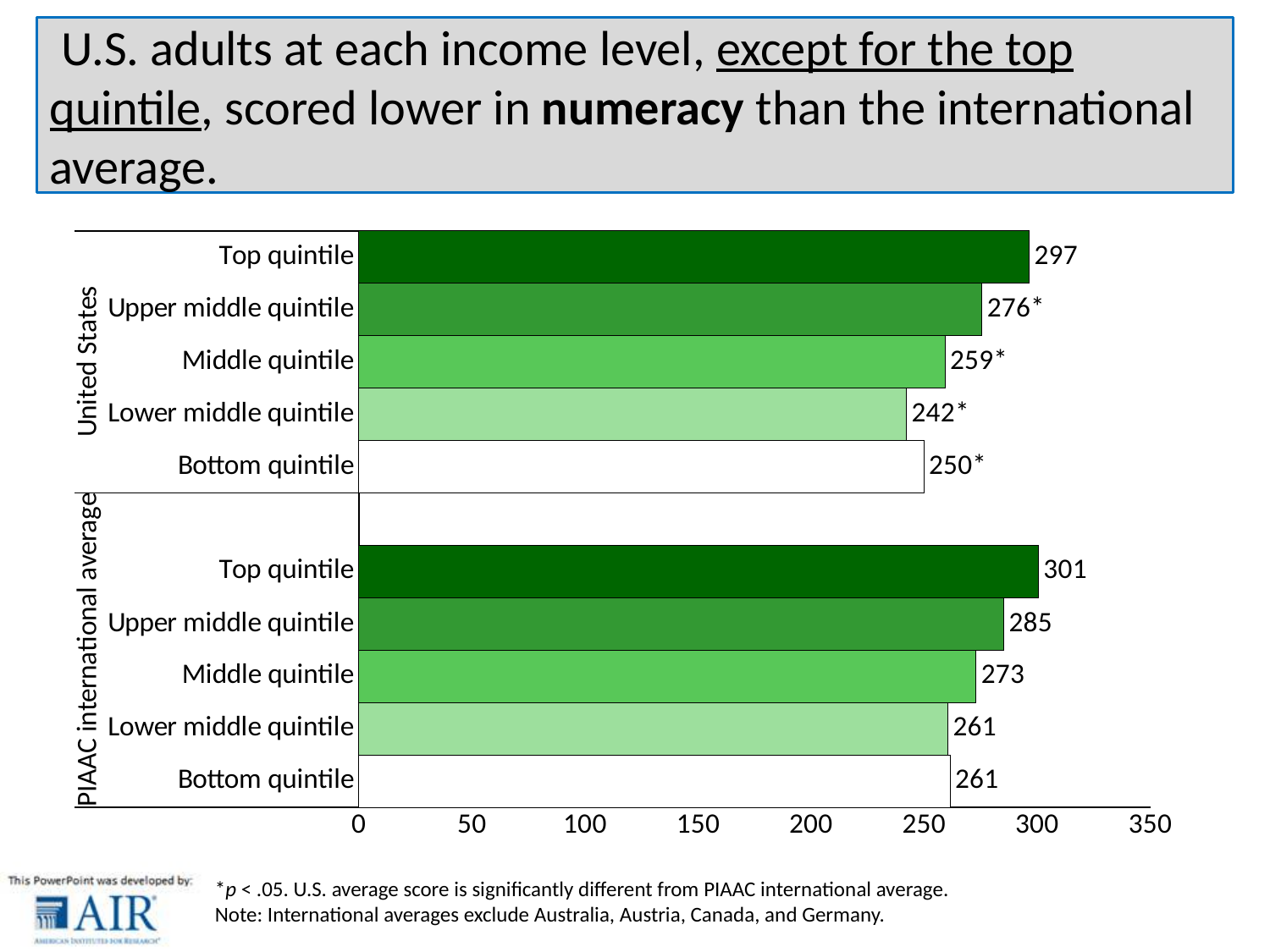
What is the numeracy score for the PIAAC international average upper middle quintile? 285 What type of chart is shown on the slide? Bar chart What is the numeracy score for the United States top quintile? 297 Is the United States bottom quintile score greater or less than 300? less Which is larger: the United States middle quintile score or the PIAAC international average middle quintile score? PIAAC international average middle quintile What is the numeracy score for the PIAAC international average bottom quintile? 261 How many bars are plotted in the chart? 10 What is the numeracy score for the United States lower middle quintile? 242* Which United States income quintile has the lowest numeracy score? Lower middle quintile What is the difference between the PIAAC international average and the United States score for the top quintile? 4 Which bar in the chart has the highest value overall? PIAAC international average Top quintile What is the difference between the PIAAC international average and the United States score for the lower middle quintile? 19